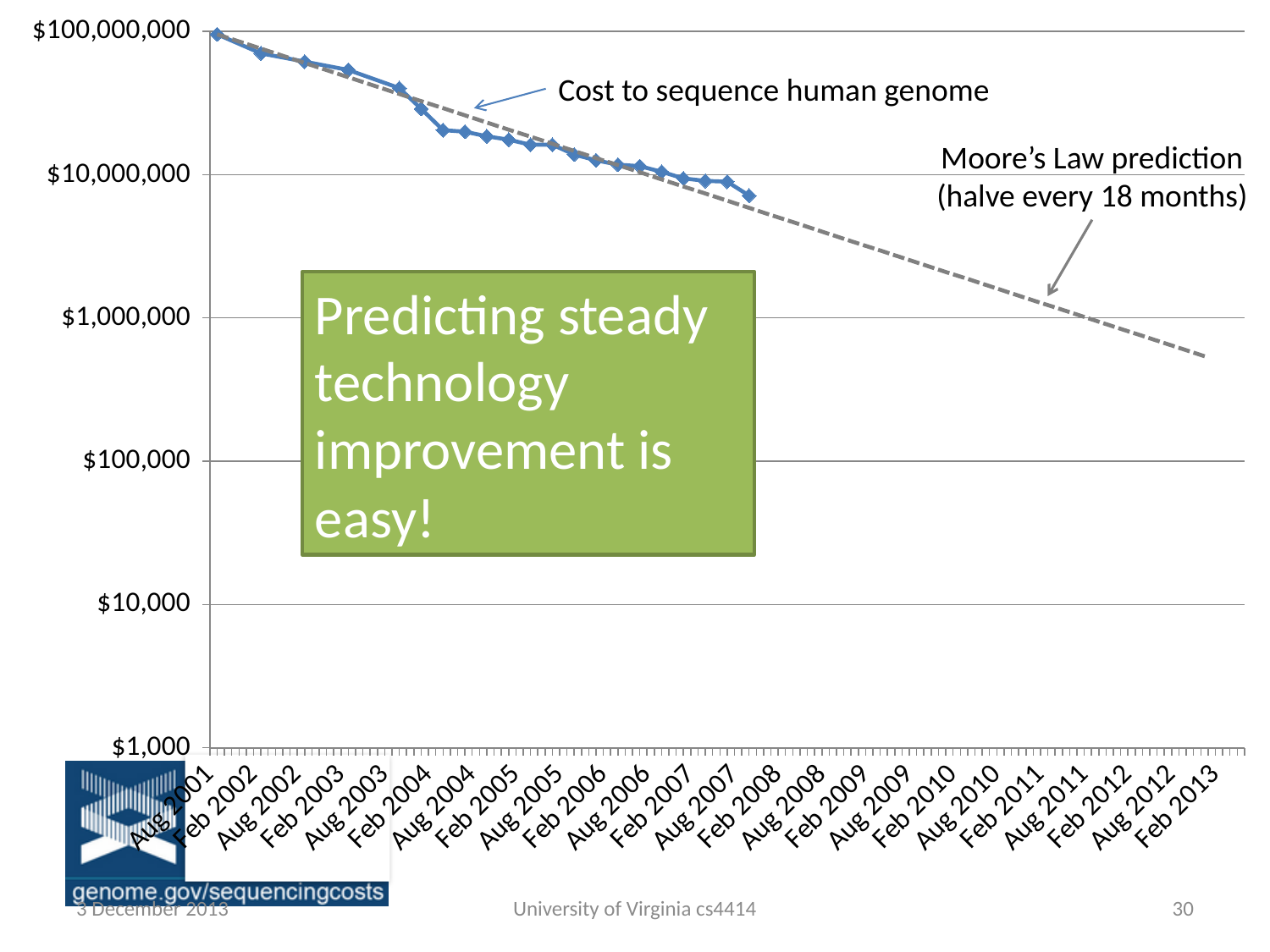
Is the Moore's Law prediction for Aug 2009 greater or less than $1,000,000? greater What does the solid blue line with diamond markers represent? Cost to sequence human genome At which date is the cost to sequence a human genome highest? Aug 2001 What kind of chart is shown on the slide? line chart Is the cost to sequence a human genome in Aug 2001 greater or less than $10,000,000? greater In Aug 2004, which is higher: the actual cost to sequence a human genome or the Moore's Law prediction? Moore's Law prediction Does the cost to sequence a human genome rise or fall over time along the x axis? fall How many data series are plotted on the chart? 2 What does the dashed gray line on the chart represent? Moore's Law prediction (halve every 18 months) What is the highest value shown on the y axis? $100,000,000 Is the cost to sequence a human genome at its last plotted point (Feb 2008) greater or less than $10,000,000? less